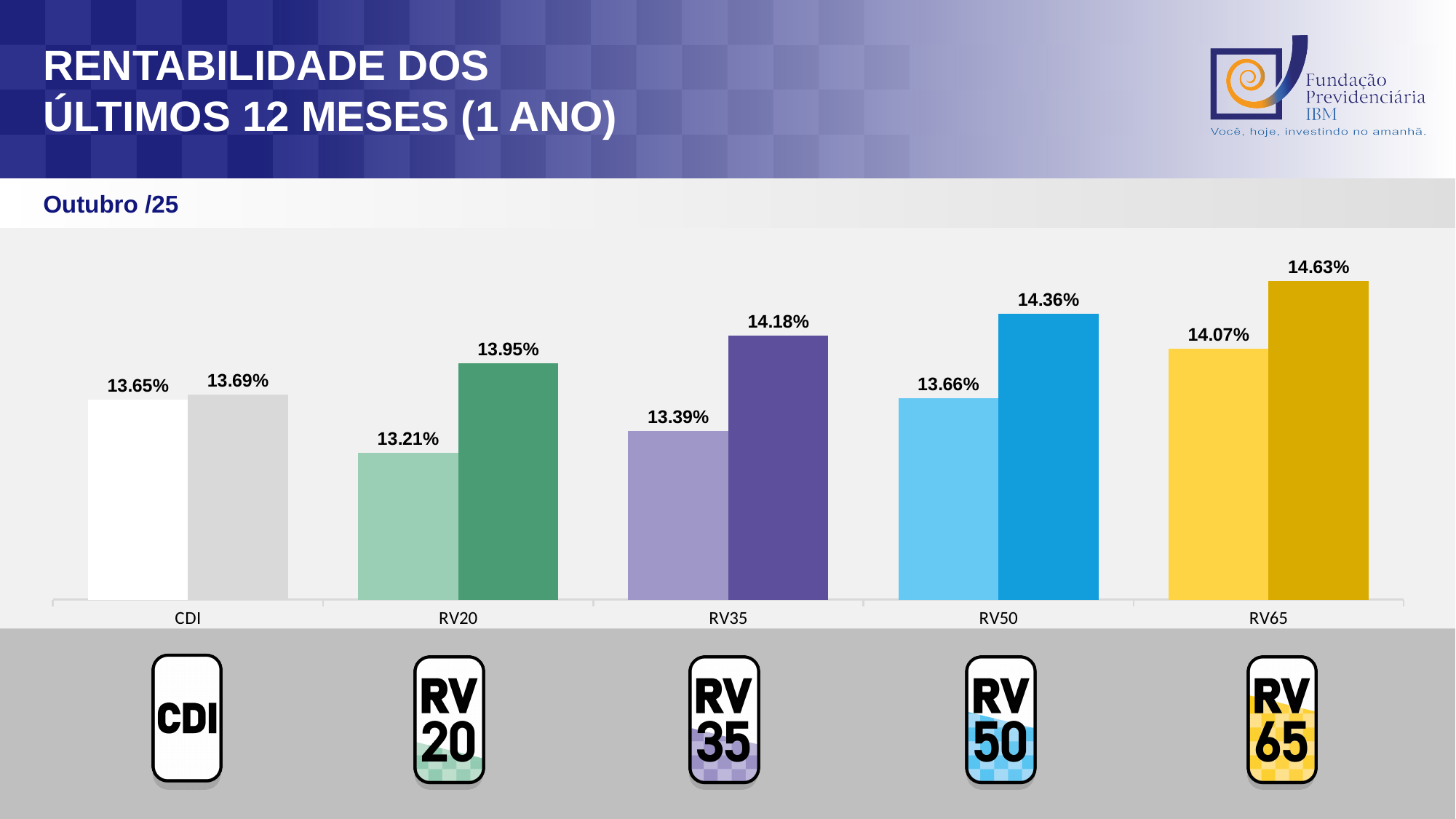
What value is shown for the left-hand (white) bar of CDI? 13.65% Which category contains the lowest value on the chart? RV20 What is the title of the slide? RENTABILIDADE DOS ÚLTIMOS 12 MESES (1 ANO) What is the difference between the two bars shown for RV65? 0.56 percentage points Do the values of the right-hand (darker) bars rise or fall from CDI to RV65? Rise Which category has the highest value on the chart? RV65 What kind of chart is shown on the slide? Bar chart What value is shown for the left-hand (lighter) bar of RV20? 13.21% What value is shown for the right-hand (darker) bar of RV65? 14.63% What is the difference between the two bars shown for RV50? 0.70 percentage points How many categories are shown on the x axis? 5 Which is larger: the right-hand bar of RV35 or the left-hand bar of RV50? The right-hand bar of RV35